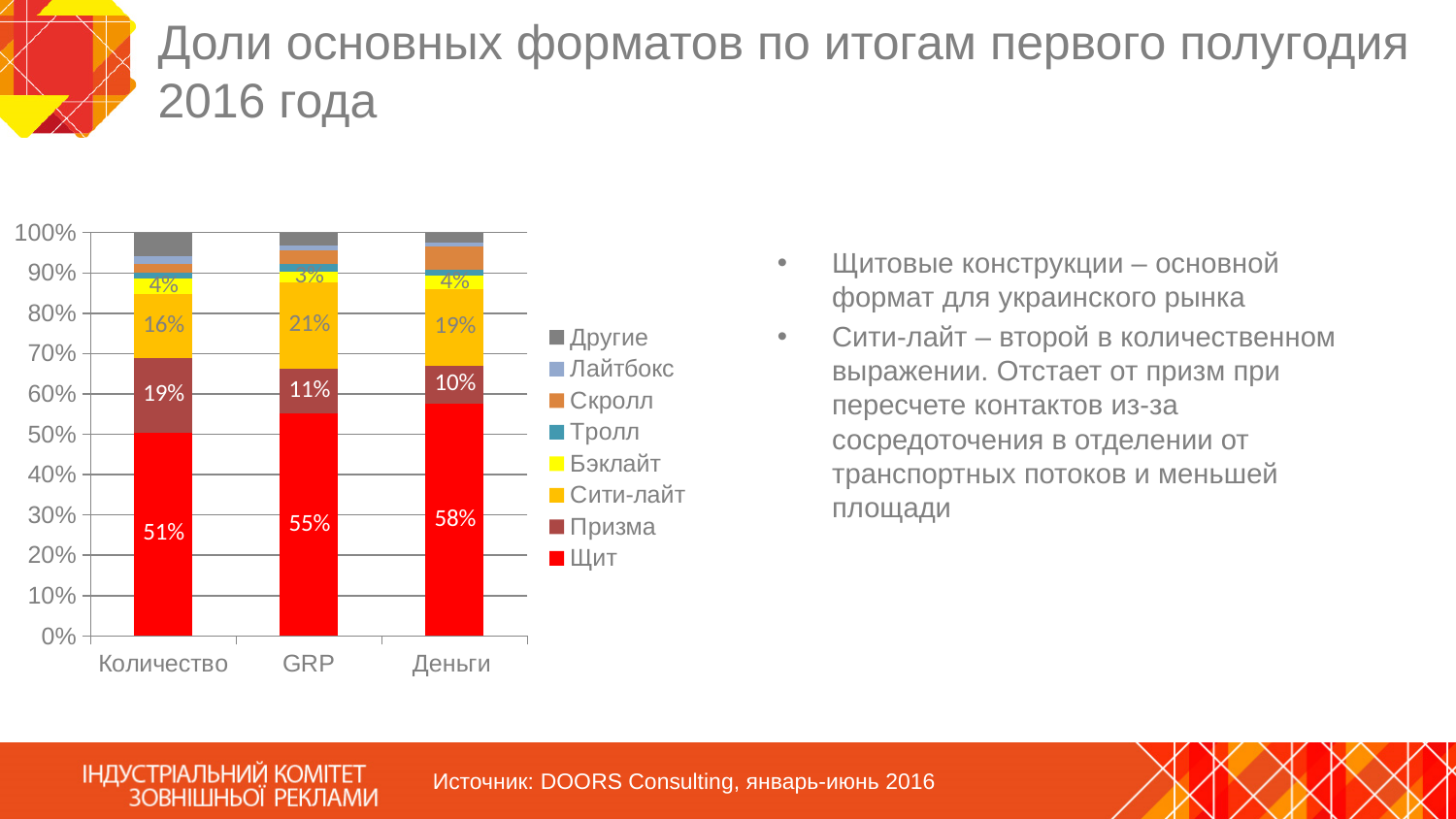
How many series does the legend list? 8 How many categories are shown on the x axis? 3 Which is larger: the Сити-лайт share in Количество or in Деньги? Деньги What is the difference between the Щит share in Деньги and in Количество? 7% What share does Призма have in the GRP bar? 11% What kind of chart is shown on the slide? Stacked bar chart What share does Сити-лайт have in the GRP bar? 21% What share does Щит have in the Деньги bar? 58% What share does Щит have in the Количество bar? 51% In which category is the Щит share the highest? Деньги What share does Бэклайт have in the Количество bar? 4% In which category is the Призма share the lowest? Деньги